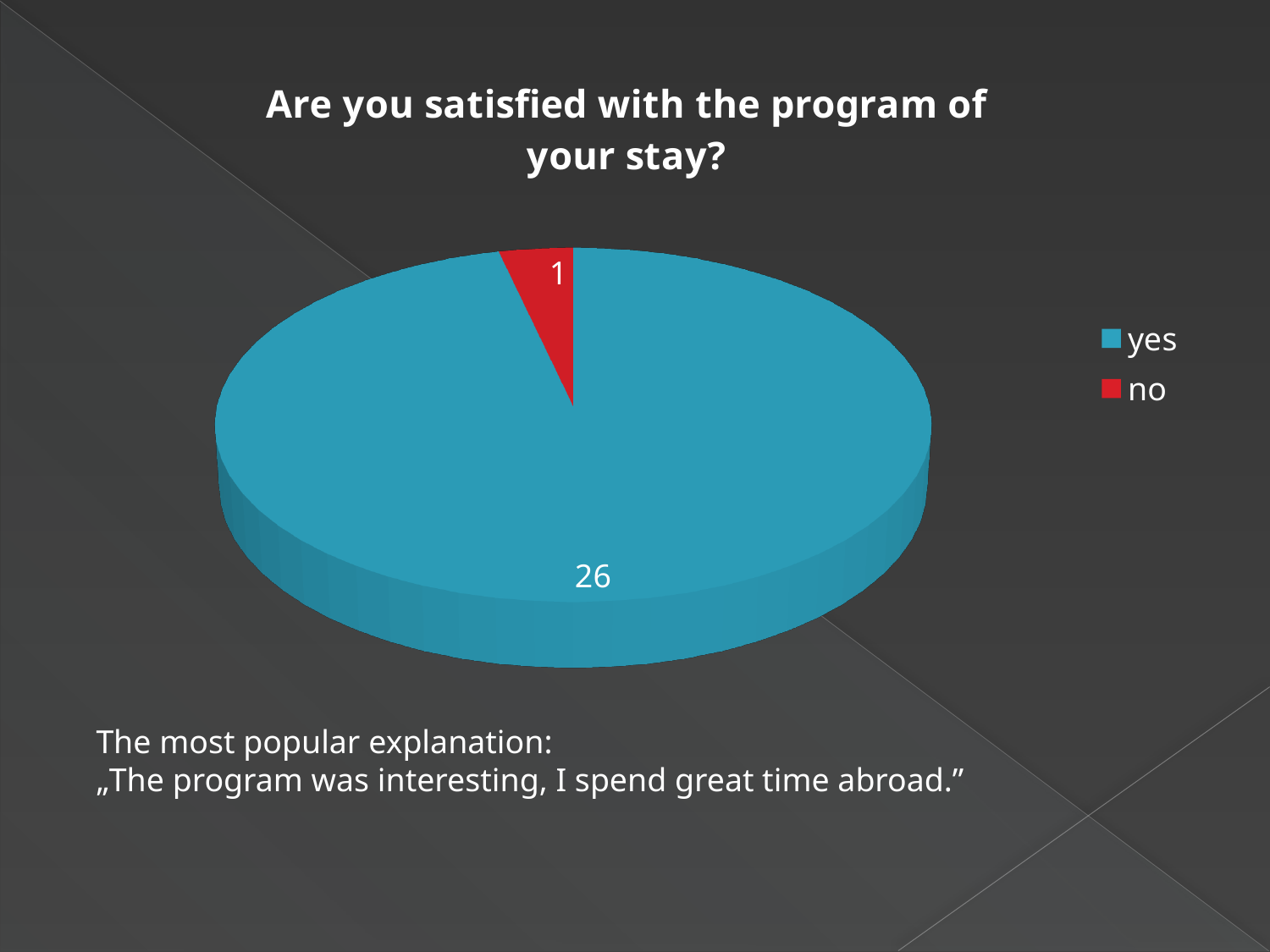
What is the total of all slices in the pie chart? 27 What is the value for "no"? 1 How many categories does the pie chart show? 2 Which is larger, the value for "yes" or the value for "no"? yes What is the value for "yes"? 26 Which category has the largest slice? yes What is the difference between the "yes" and "no" values? 25 What is the title of the chart? Are you satisfied with the program of your stay? How many entries does the legend list? 2 Which category has the smallest slice? no What kind of chart is shown on the slide? pie chart What colour is the "no" slice? red